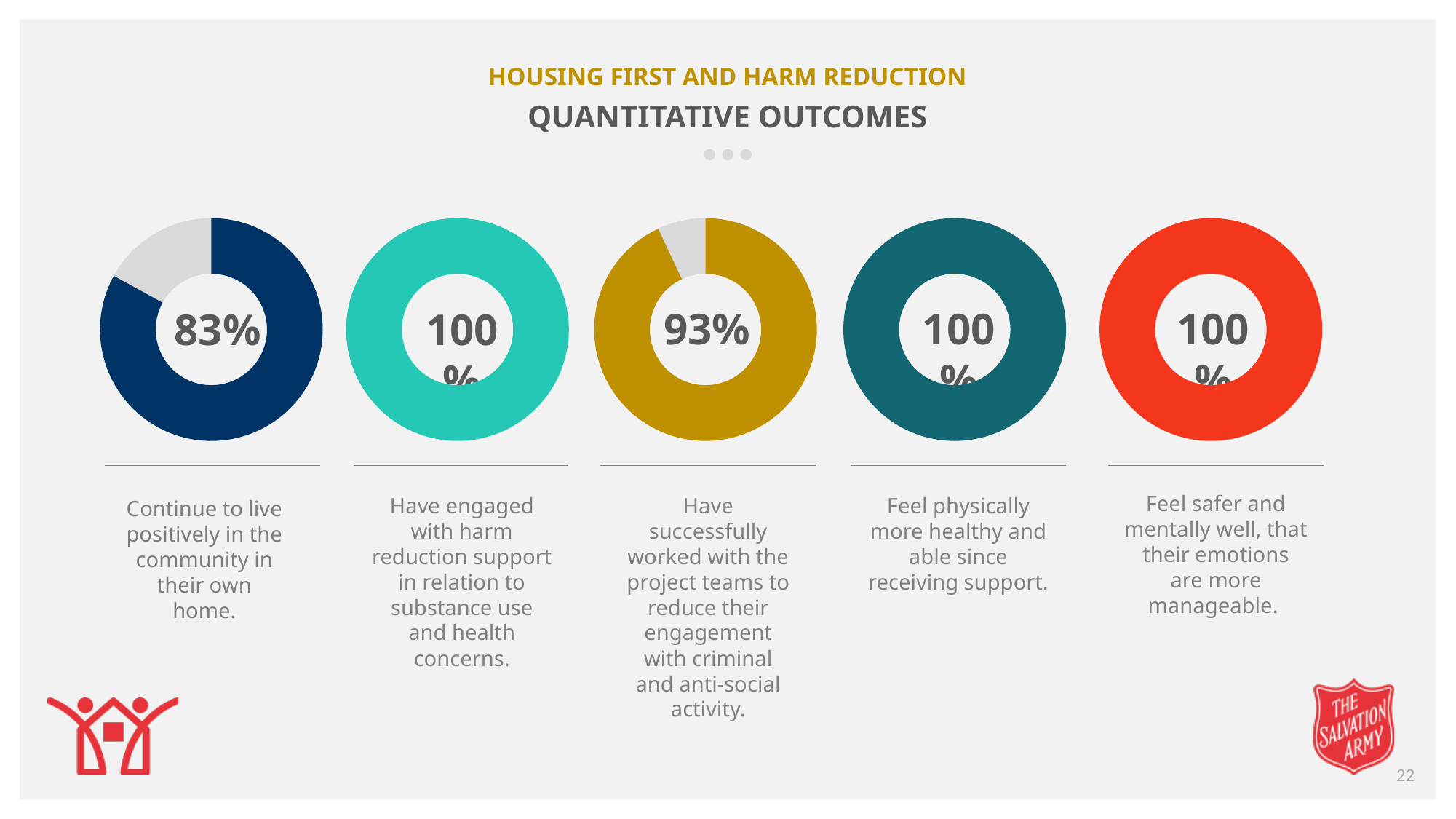
On the fourth donut chart from the left, what percentage feel physically more healthy and able since receiving support? 100% What is the difference in percentage points between the third donut chart (93%) and the leftmost donut chart (83%)? 10 percentage points On the third donut chart from the left, what percentage have successfully worked with the project teams to reduce their engagement with criminal and anti-social activity? 93% Which outcome has the lowest percentage among the five donut charts? Continue to live positively in the community in their own home (83%) On the leftmost donut chart, what percentage is shown for those who continue to live positively in the community in their own home? 83% What is the main title shown above the donut charts? Quantitative Outcomes How many of the donut charts show a value of 100%? 3 Which is larger: the value on the leftmost donut chart or the value on the third donut chart from the left? The third donut chart (93%) On the second donut chart from the left, what percentage have engaged with harm reduction support in relation to substance use and health concerns? 100% How many donut charts are shown on the slide? 5 What colour is the filled portion of the leftmost donut chart? Dark blue What kind of chart is used to display each outcome on the slide? Donut chart